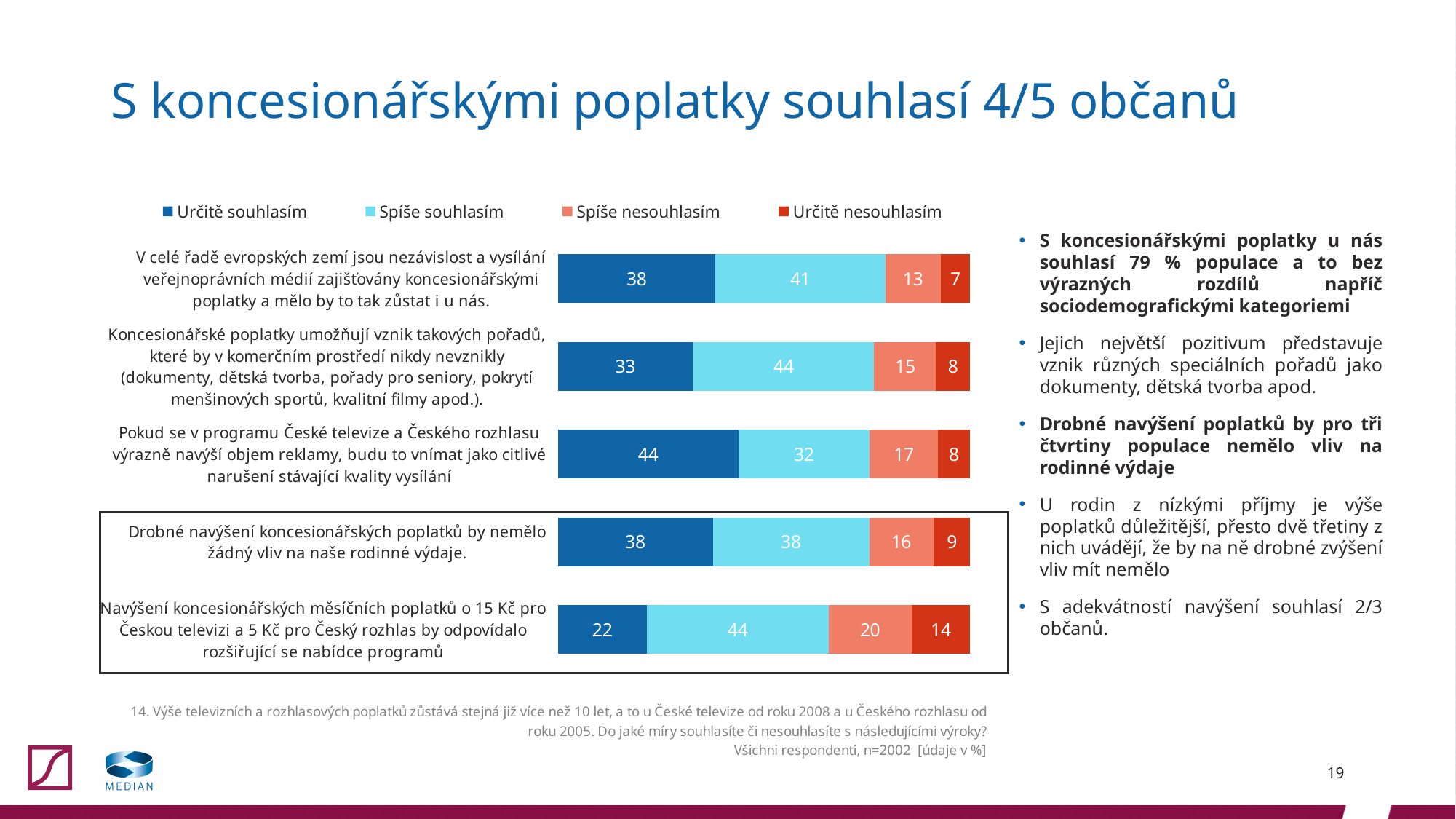
How many statements (bars) are plotted in the chart? 5 Which statement has the highest "Určitě souhlasím" value? Pokud se v programu České televize a Českého rozhlasu výrazně navýší objem reklamy, budu to vnímat jako citlivé narušení stávající kvality vysílání What kind of chart is shown on the slide? Stacked bar chart What is the "Spíše souhlasím" value for the statement that in many European countries public media are financed by licence fees and it should stay that way here? 41 For the statement that licence fees enable programmes that would never arise in a commercial environment, how much larger is the "Spíše souhlasím" value than the "Určitě souhlasím" value? 11 What is the "Určitě souhlasím" value for the statement about raising monthly fees by 15 Kč for Česká televize and 5 Kč for Český rozhlas? 22 Which statement has the lowest "Určitě souhlasím" value? Navýšení koncesionářských měsíčních poplatků o 15 Kč pro Českou televizi a 5 Kč pro Český rozhlas by odpovídalo rozšiřující se nabídce programů What is the total of the four segments in the bar for the statement that a small increase in licence fees would have no effect on family expenses? 101 Which has the larger "Spíše nesouhlasím" value: the statement about raising fees by 15 Kč, or the statement about a significant increase in advertising? The statement about raising fees by 15 Kč How many series does the chart legend list? 4 Which legend entry is shown in dark red? Určitě nesouhlasím What is the "Určitě nesouhlasím" value for the statement about raising monthly fees by 15 Kč for Česká televize and 5 Kč for Český rozhlas? 14